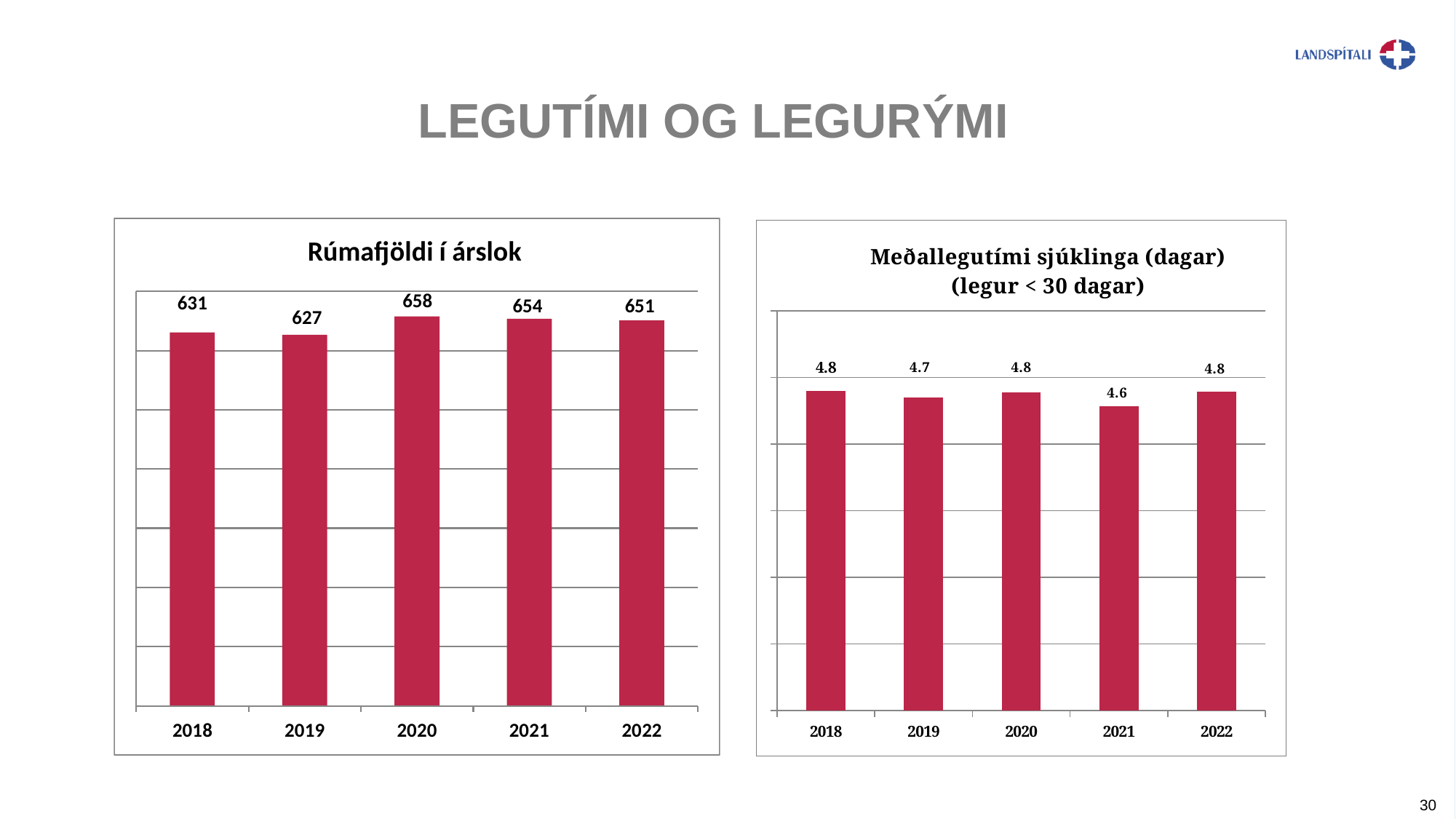
What kind of chart is the 'Meðallegutími sjúklinga (dagar)' chart? Bar chart In the 'Meðallegutími sjúklinga (dagar)' chart, which year has the lowest value? 2021 In the 'Rúmafjöldi í árslok' chart, what is the value for 2020? 658 In the 'Meðallegutími sjúklinga (dagar)' chart, what is the value for 2019? 4.7 In the 'Rúmafjöldi í árslok' chart, which year has the highest value? 2020 In the 'Rúmafjöldi í árslok' chart, how many years are shown on the x axis? 5 In the 'Rúmafjöldi í árslok' chart, which year has the lowest value? 2019 In the 'Rúmafjöldi í árslok' chart, what is the difference between the values for 2020 and 2018? 27 In the 'Rúmafjöldi í árslok' chart, what is the value for 2019? 627 In the 'Meðallegutími sjúklinga (dagar)' chart, what is the difference between the values for 2018 and 2021? 0.2 In the 'Meðallegutími sjúklinga (dagar)' chart, what is the value for 2021? 4.6 In the 'Rúmafjöldi í árslok' chart, is the value for 2021 larger or smaller than the value for 2022? Larger